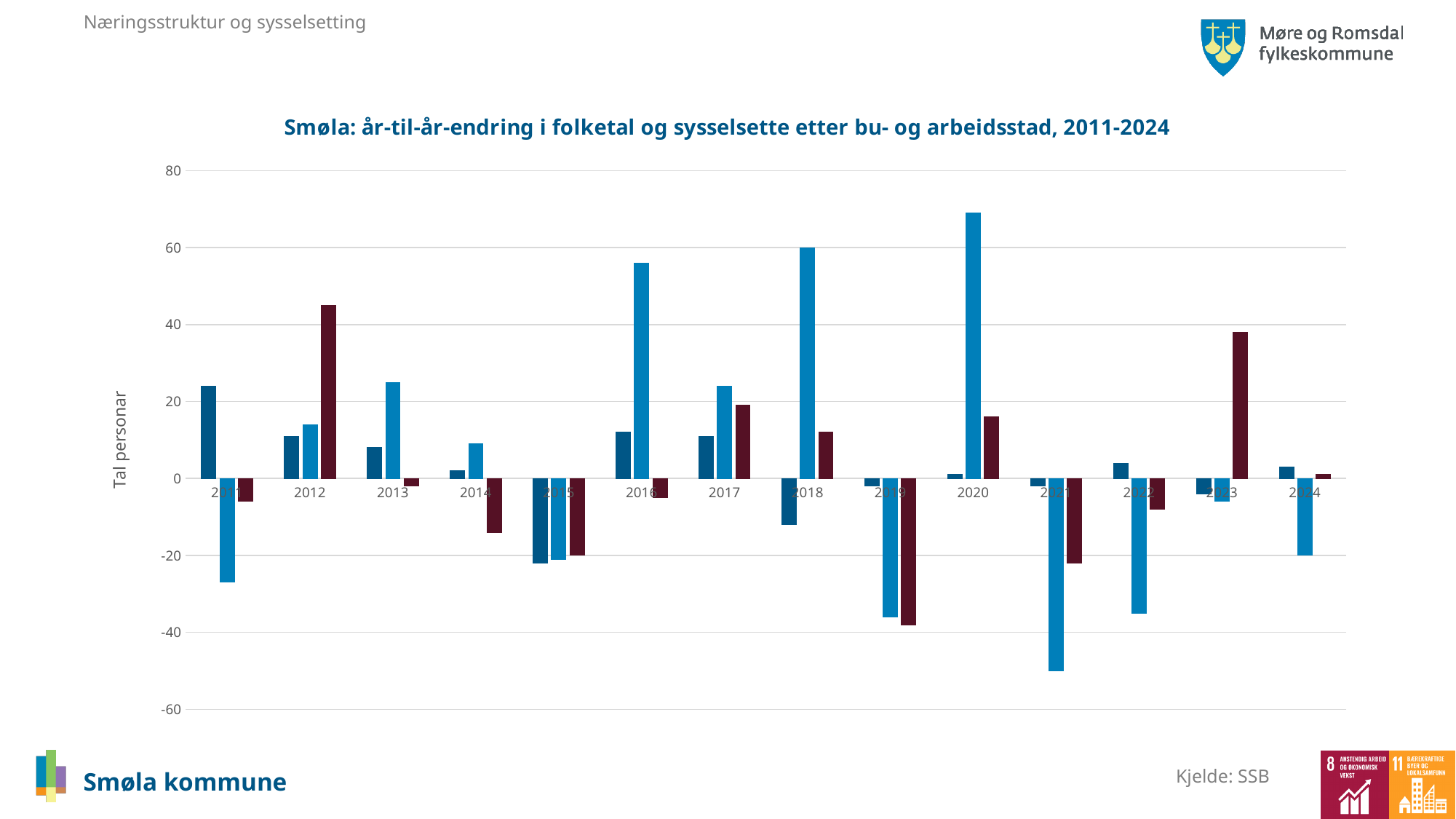
Is the value of the light blue bar for 2016 greater or less than 40? greater How many years are shown along the x axis of the chart? 14 Is the value of the light blue bar for 2021 greater or less than -40? less What kind of chart is shown on the slide? bar chart Is the value of the dark red bar for 2012 greater or less than 40? greater What is the label on the vertical axis of the chart? Tal personar In which year is the light blue bar the lowest? 2021 What is the title of the chart? Smøla: år-til-år-endring i folketal og sysselsette etter bu- og arbeidsstad, 2011-2024 In which year is the light blue bar the highest? 2020 Which is larger, the dark red bar for 2023 or the dark red bar for 2024? 2023